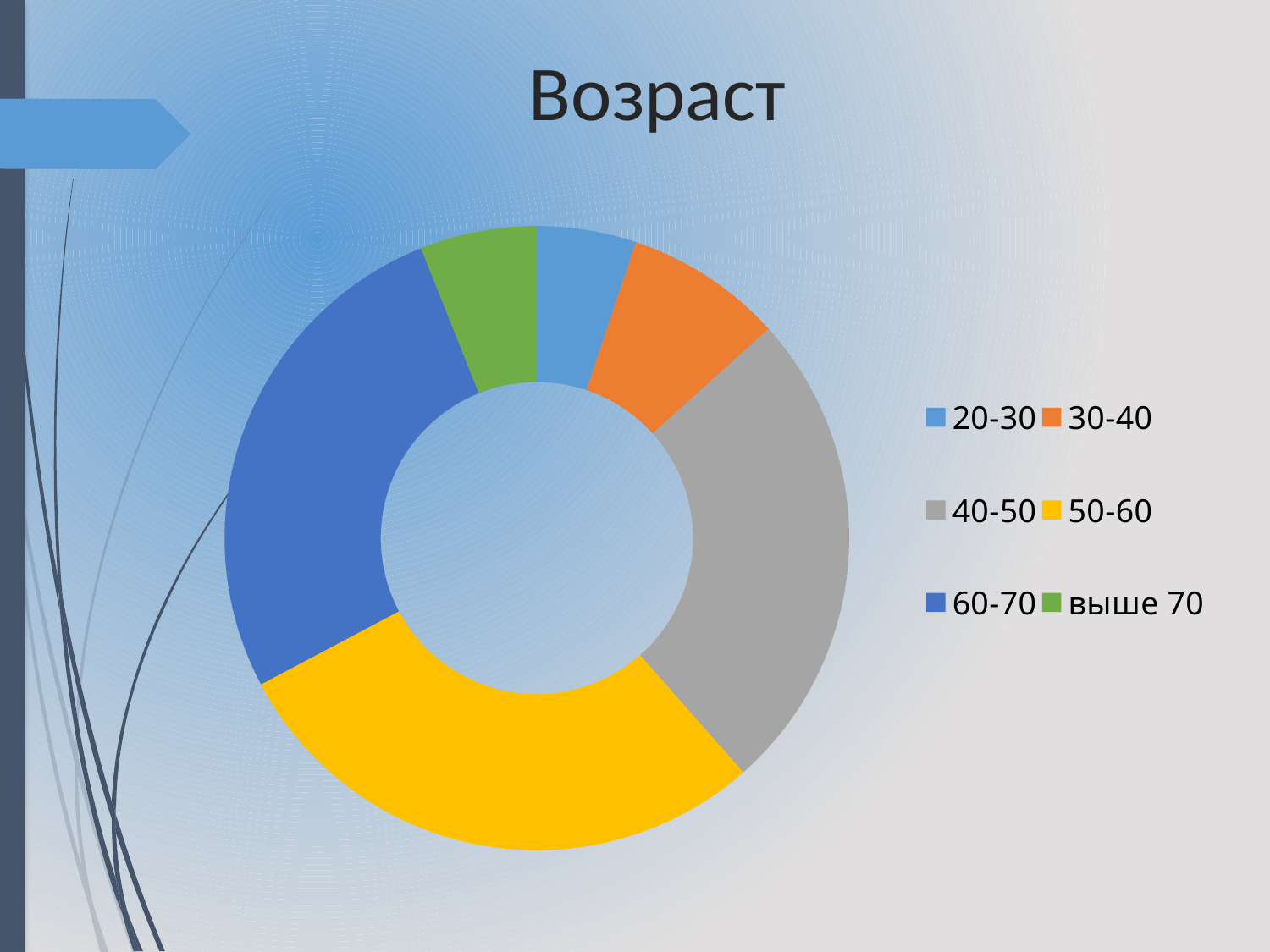
How many age categories does the chart show? 6 Which colour represents the 50-60 category in the legend? yellow Which category is shown in green? выше 70 Which is larger, the share for 40-50 or the share for 30-40? 40-50 What kind of chart is shown on the slide? doughnut (pie) chart Which is larger, the share for 30-40 or the share for выше 70? 30-40 Which is larger, the share for 50-60 or the share for 20-30? 50-60 Which age category has the largest share of the chart? 50-60 What is the title of the chart? Возраст